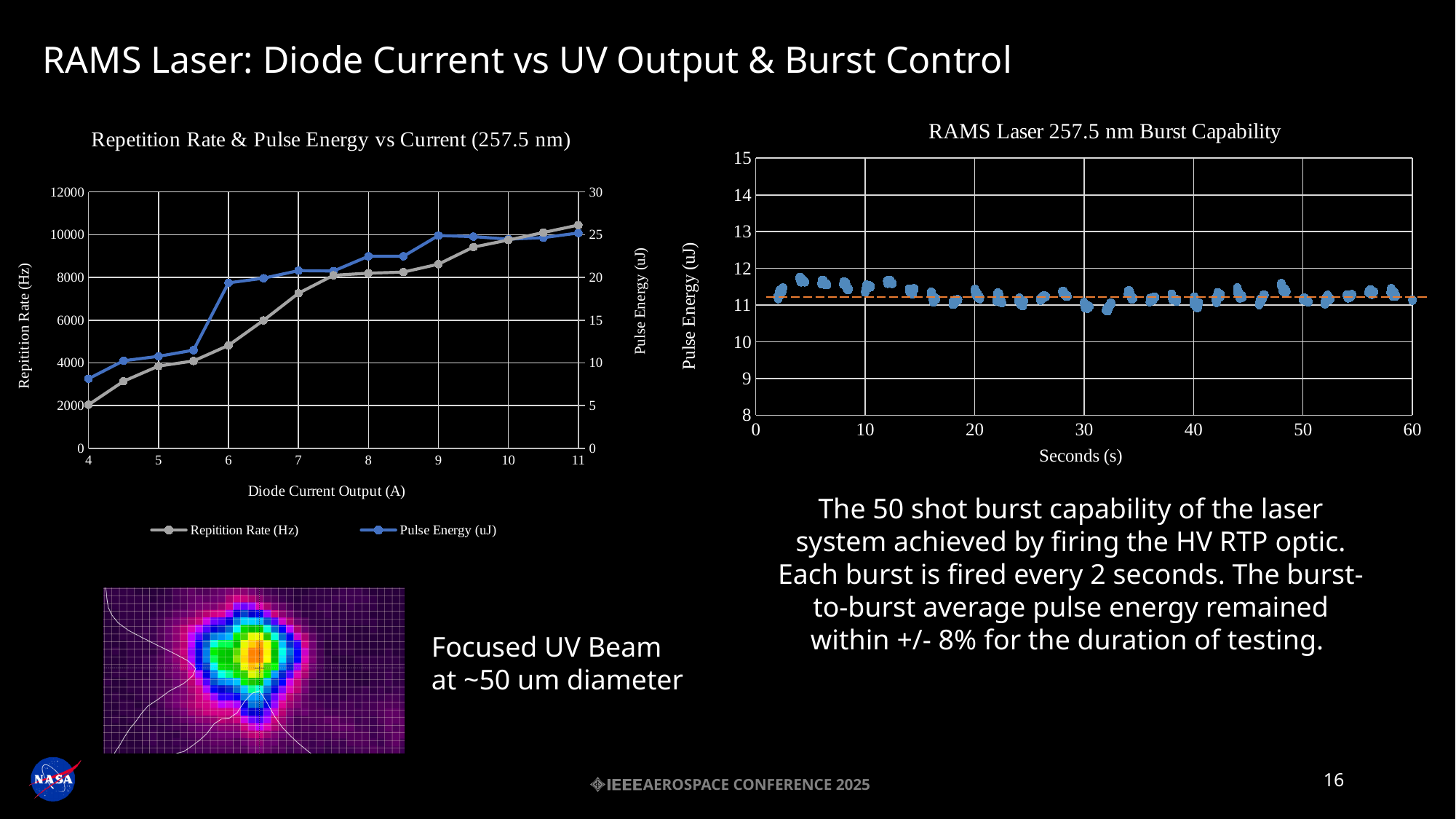
In the 'Repetition Rate & Pulse Energy vs Current (257.5 nm)' chart, at which Diode Current Output is the Repetition Rate highest? 11 In the 'Repetition Rate & Pulse Energy vs Current (257.5 nm)' chart, is the Pulse Energy at 6 A greater or less than 15? greater In the 'RAMS Laser 257.5 nm Burst Capability' chart, are the plotted Pulse Energy values greater or less than 10? greater In the 'Repetition Rate & Pulse Energy vs Current (257.5 nm)' chart, at which Diode Current Output is the Pulse Energy lowest? 4 In the 'Repetition Rate & Pulse Energy vs Current (257.5 nm)' chart, how many data points does each series have along the Diode Current Output axis? 15 In the 'Repetition Rate & Pulse Energy vs Current (257.5 nm)' chart, is the Repetition Rate at 11 A greater or less than 10000? greater What kind of chart is the 'Repetition Rate & Pulse Energy vs Current (257.5 nm)' chart? line chart What is the x-axis label of the 'RAMS Laser 257.5 nm Burst Capability' chart? Seconds (s) In the 'Repetition Rate & Pulse Energy vs Current (257.5 nm)' chart, is the Pulse Energy larger at 5 A or at 6 A? 6 A How many series does the legend of the 'Repetition Rate & Pulse Energy vs Current (257.5 nm)' chart list? 2 In the 'Repetition Rate & Pulse Energy vs Current (257.5 nm)' chart, does the Repetition Rate rise or fall as Diode Current Output increases? rise